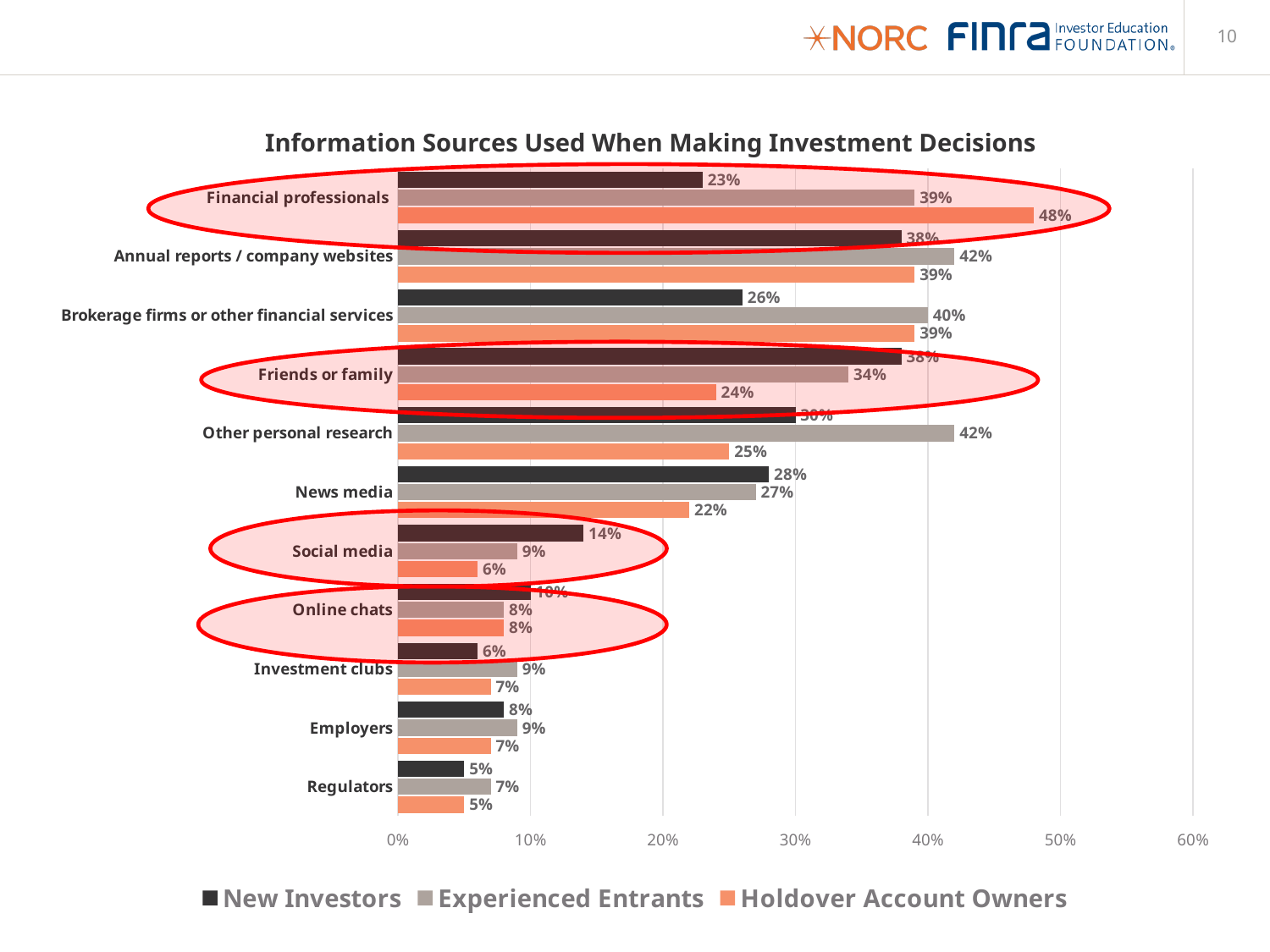
How many series does the legend list? 3 Which category has the highest value for Holdover Account Owners? Financial professionals What is the difference between the Holdover Account Owners and New Investors values for Financial professionals? 25% What is the value for New Investors for Social media? 14% What is the title of the chart? Information Sources Used When Making Investment Decisions What is the value for Holdover Account Owners for Financial professionals? 48% How many categories are shown on the chart? 11 For News media, which is larger: the New Investors value or the Holdover Account Owners value? New Investors What kind of chart is shown on the slide? Bar chart What is the value for Experienced Entrants for Other personal research? 42% Which category has the lowest value for New Investors? Regulators What is the value for Experienced Entrants for Brokerage firms or other financial services? 40%